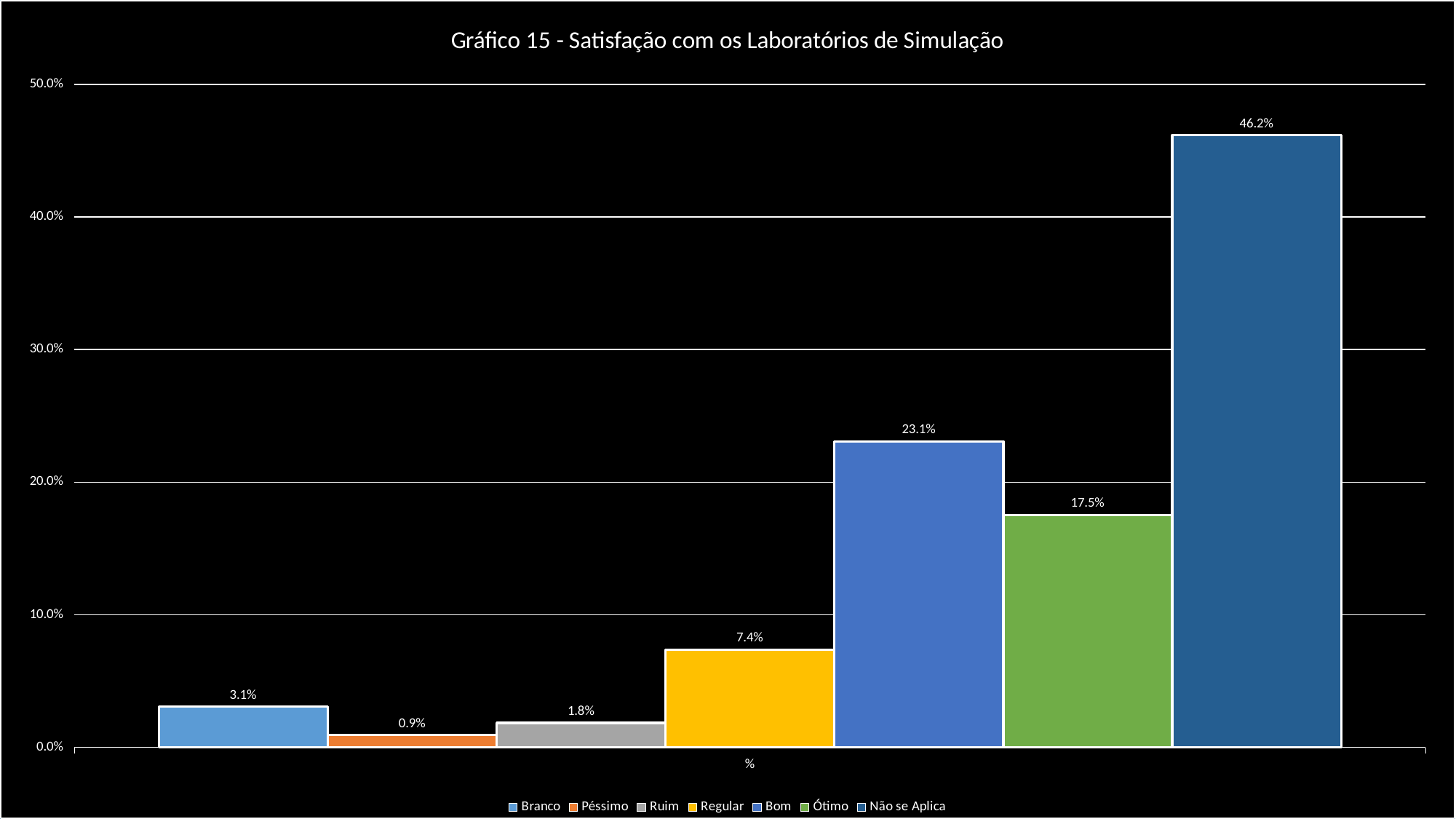
What is the value for Regular? 7.4% Which category has the highest value? Não se Aplica What is the value for Péssimo? 0.9% What is the value for Não se Aplica? 46.2% What kind of chart is shown? bar chart What is the difference between the values for Bom and Ótimo? 5.6% What is the title of the chart? Gráfico 15 - Satisfação com os Laboratórios de Simulação Which category has the lowest value? Péssimo Which is larger, the value for Branco or the value for Ruim? Branco How many series does the legend list? 7 Is the value for Ótimo greater or less than 20.0%? less What is the value for Bom? 23.1%